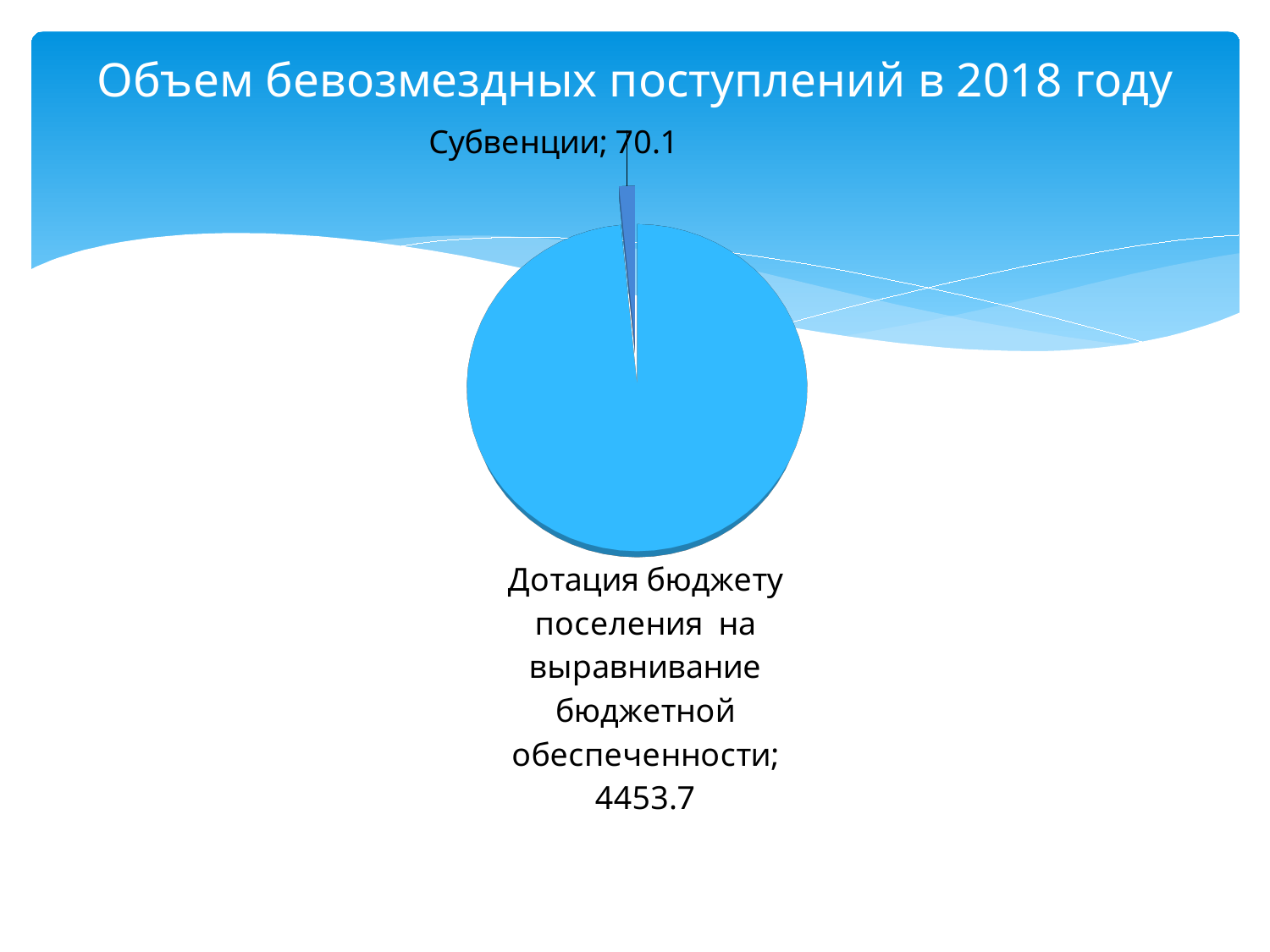
What kind of chart is shown on the slide? pie chart How many slices does the pie chart have? 2 Which slice of the pie is the largest? Дотация бюджету поселения на выравнивание бюджетной обеспеченности Which year does the chart refer to? 2018 What is the title of the chart? Объем бевозмездных поступлений в 2018 году What is the value for Субвенции? 70.1 Which is larger: Субвенции or Дотация бюджету поселения на выравнивание бюджетной обеспеченности? Дотация бюджету поселения на выравнивание бюджетной обеспеченности What is the value for Дотация бюджету поселения на выравнивание бюджетной обеспеченности? 4453.7 What is the total of the two values shown in the pie chart? 4523.8 What is the difference between the value for Дотация бюджету поселения на выравнивание бюджетной обеспеченности and the value for Субвенции? 4383.6 Which slice of the pie is the smallest? Субвенции